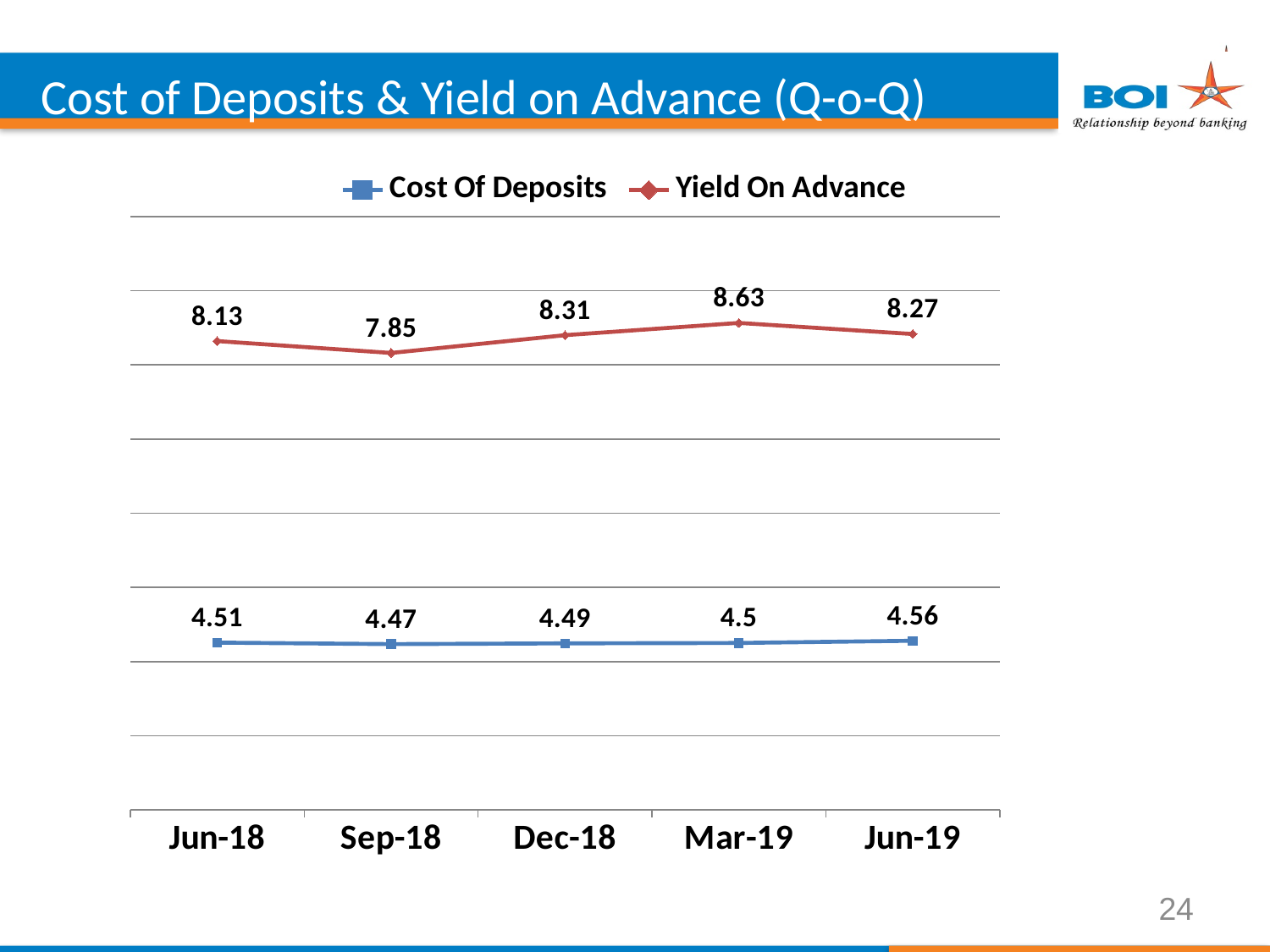
What is the Yield On Advance value for Mar-19? 8.63 What is the Cost Of Deposits value for Sep-18? 4.47 What kind of chart is shown on the slide? Line chart How many series does the legend list? 2 What is the difference between Yield On Advance in Mar-19 and Sep-18? 0.78 In which quarter is Yield On Advance lowest? Sep-18 How many quarters are shown on the x axis? 5 Which is larger: Yield On Advance in Dec-18 or in Jun-18? Dec-18 What is the difference between Cost Of Deposits in Jun-19 and Jun-18? 0.05 What is the Yield On Advance value for Jun-19? 8.27 Which colour is used for the Yield On Advance line? Red In which quarter is Cost Of Deposits highest? Jun-19